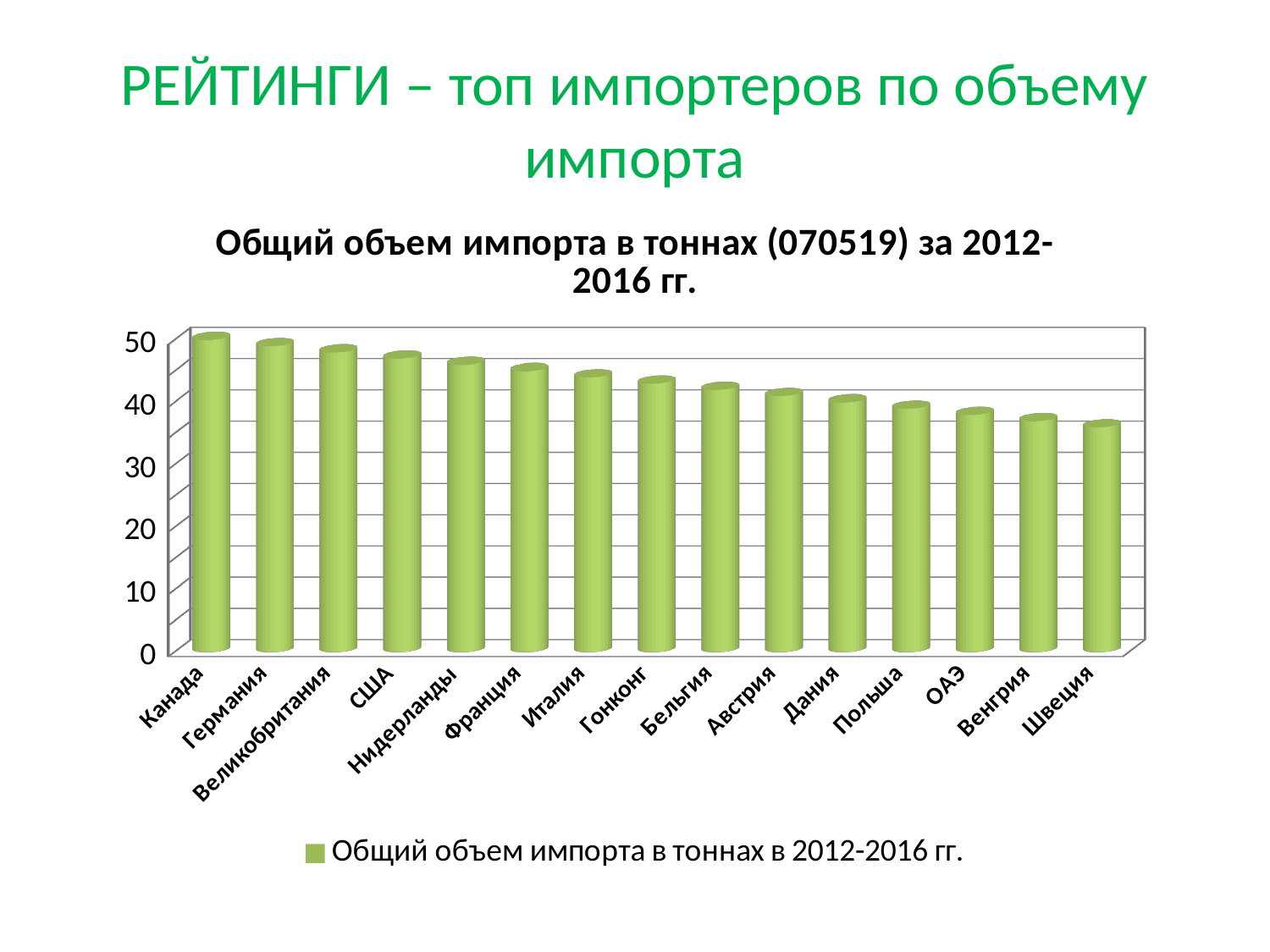
How many countries are shown on the x axis of the chart? 15 Which country has the highest total import volume in the chart? Канада Is the value for Швеция greater or less than 40? less What is the title of the chart? Общий объем импорта в тоннах (070519) за 2012-2016 гг. Which has the larger value, Германия or Венгрия? Германия How many series does the legend list? 1 Do the values rise or fall moving from left to right along the x axis? fall What kind of chart is shown on the slide? bar chart Which has the larger value, Швеция or США? США Is the value for Канада greater or less than 40? greater Which country has the lowest total import volume in the chart? Швеция Is the value for Венгрия greater or less than 40? less